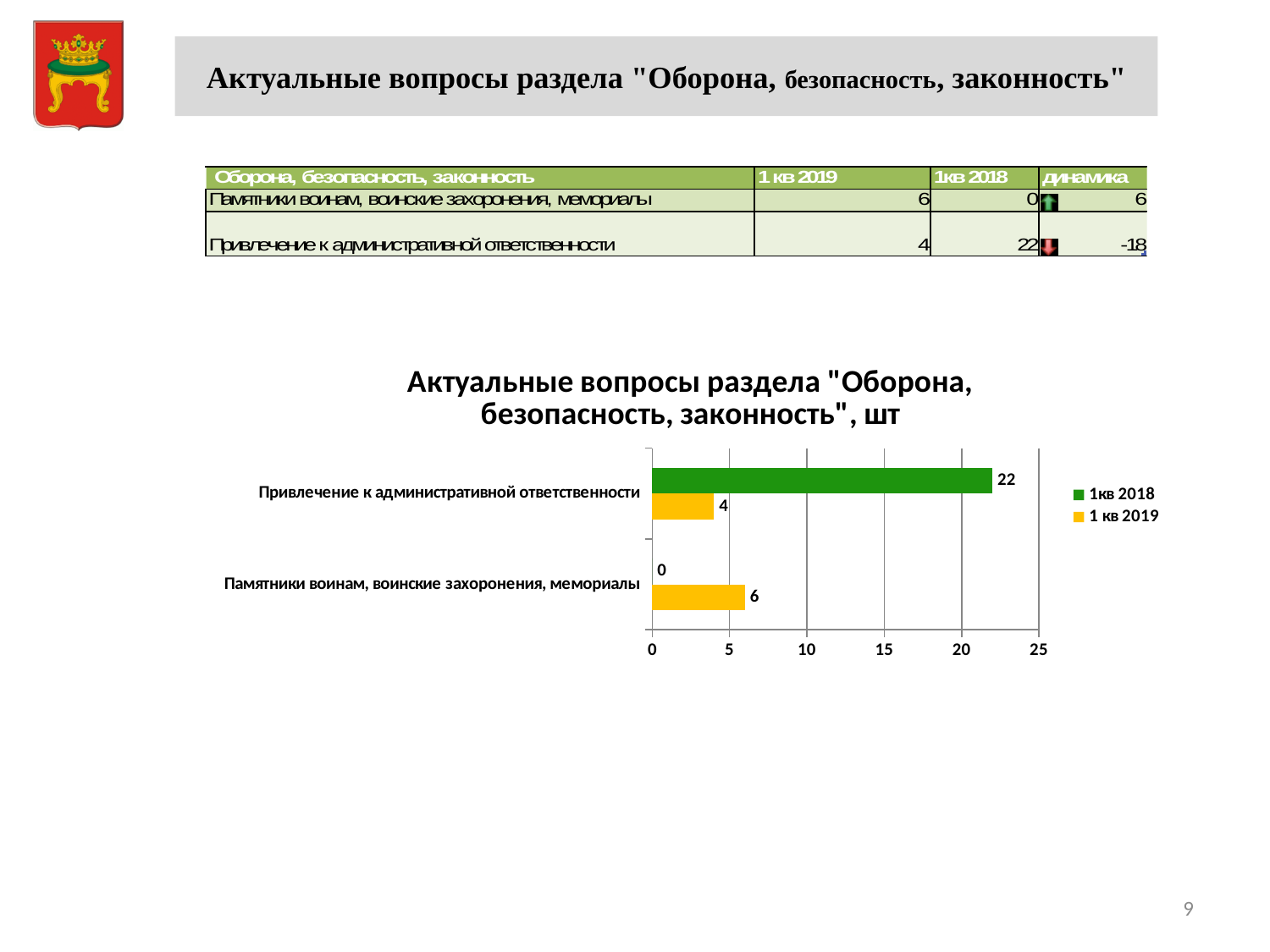
What is the difference between the "1кв 2018" and "1 кв 2019" values for "Привлечение к административной ответственности"? 18 How many categories are shown on the chart? 2 What is the title of the chart? Актуальные вопросы раздела "Оборона, безопасность, законность", шт Which is larger for "Привлечение к административной ответственности": the "1кв 2018" value or the "1 кв 2019" value? 1кв 2018 What is the value for "Привлечение к административной ответственности" in the "1кв 2018" series? 22 What is the value for "Памятники воинам, воинские захоронения, мемориалы" in the "1 кв 2019" series? 6 What colour represents the "1 кв 2019" series in the chart? yellow Which category has the highest value in the "1 кв 2019" series? Памятники воинам, воинские захоронения, мемориалы What type of chart is shown on the slide? bar chart What is the value for "Памятники воинам, воинские захоронения, мемориалы" in the "1кв 2018" series? 0 How many series does the legend list? 2 What is the value for "Привлечение к административной ответственности" in the "1 кв 2019" series? 4